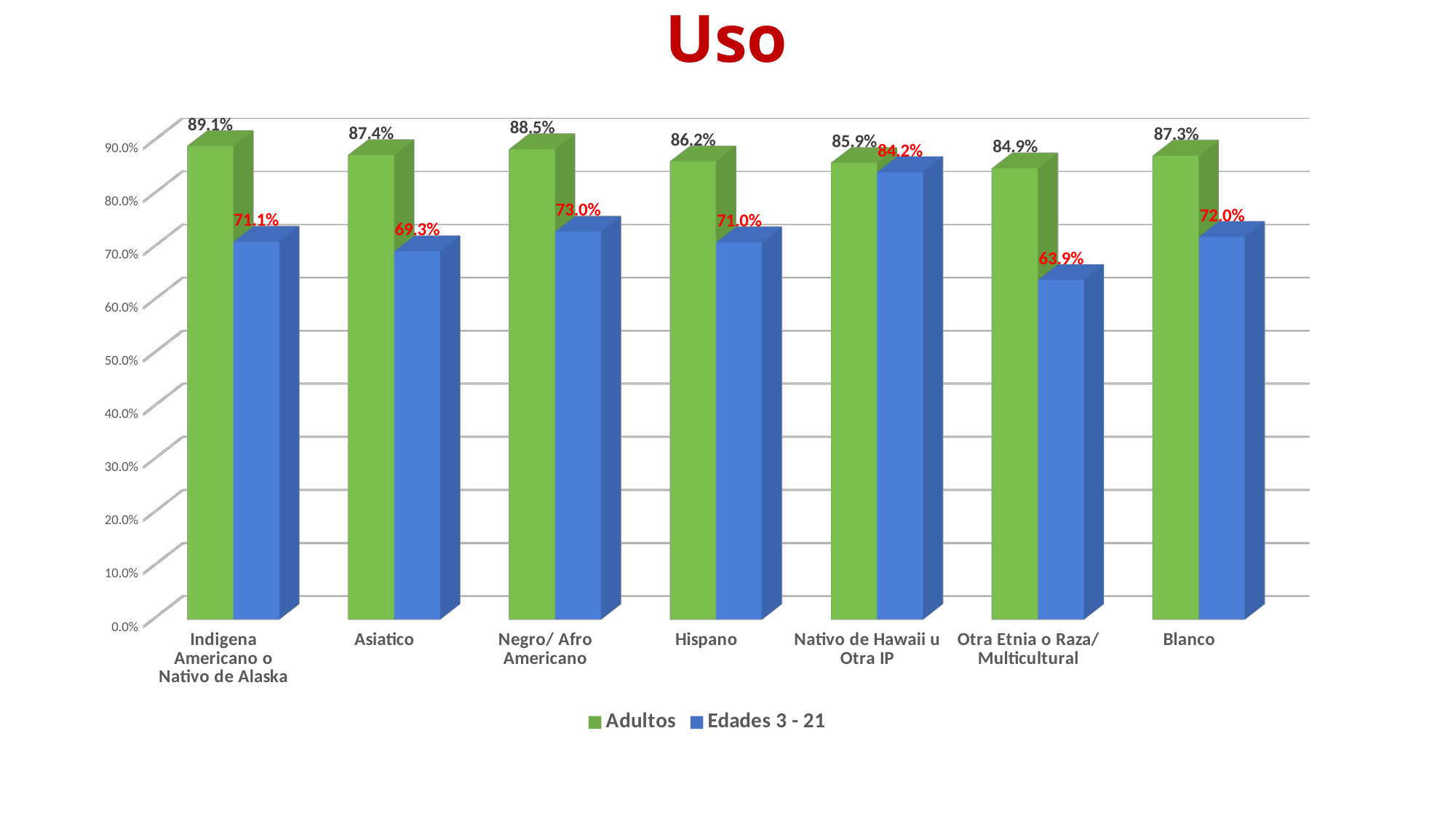
What is the Edades 3 - 21 value for Nativo de Hawaii u Otra IP? 84.2% What kind of chart is shown on the slide? bar chart How many series does the legend list? 2 What is the title of the chart? Uso What is the Adultos value for Hispano? 86.2% How many categories are shown on the x axis? 7 Is the Edades 3 - 21 value for Negro/ Afro Americano greater or less than 80.0%? less Which category has the lowest Edades 3 - 21 value? Otra Etnia o Raza/ Multicultural Which category has the highest Adultos value? Indigena Americano o Nativo de Alaska What is the difference between the Adultos and Edades 3 - 21 values for Blanco? 15.3% What is the Edades 3 - 21 value for Otra Etnia o Raza/ Multicultural? 63.9% Which is larger for Asiatico: the Adultos value or the Edades 3 - 21 value? Adultos